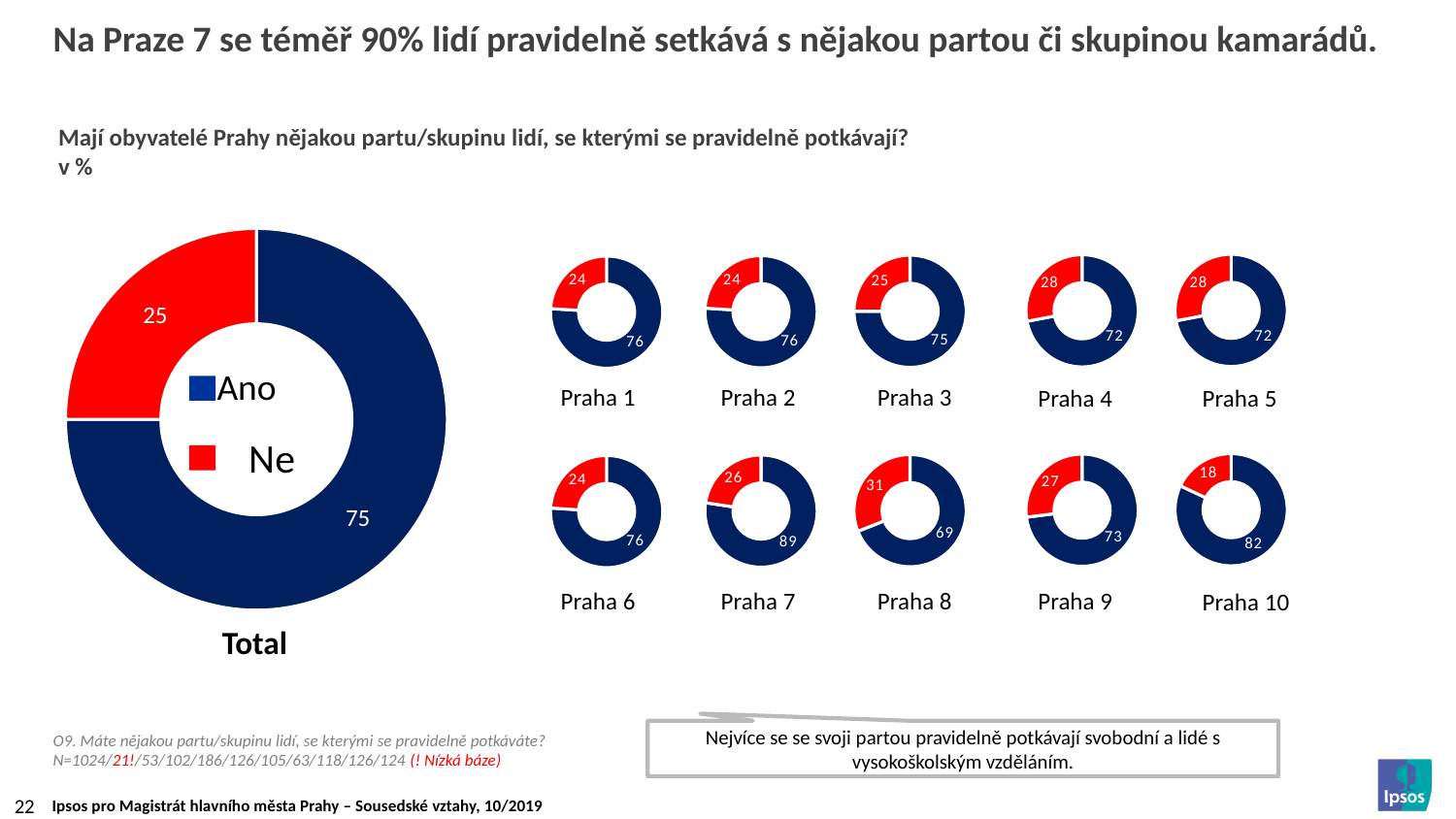
In the Praha 10 chart, what is the value shown for the red (Ne) segment? 18 What type of chart is the Total chart? Donut chart In the Total chart, what is the value for Ne? 25 Among the Praha 1 to Praha 10 charts, which district has the lowest Ano value? Praha 8 How many district charts (Praha 1 to Praha 10) are shown on the slide? 10 In the Total chart, what is the value for Ano? 75 What is the difference between the Ano value in the Praha 10 chart and the Ano value in the Praha 8 chart? 13 How many series does the legend of the Total chart list? 2 In the Praha 8 chart, what is the value shown for the red (Ne) segment? 31 In the Praha 7 chart, what is the value shown for the dark blue (Ano) segment? 89 Is the Ne value larger in the Praha 4 chart or in the Praha 9 chart? Praha 4 Among the Praha 1 to Praha 10 charts, which district has the highest Ano value? Praha 7